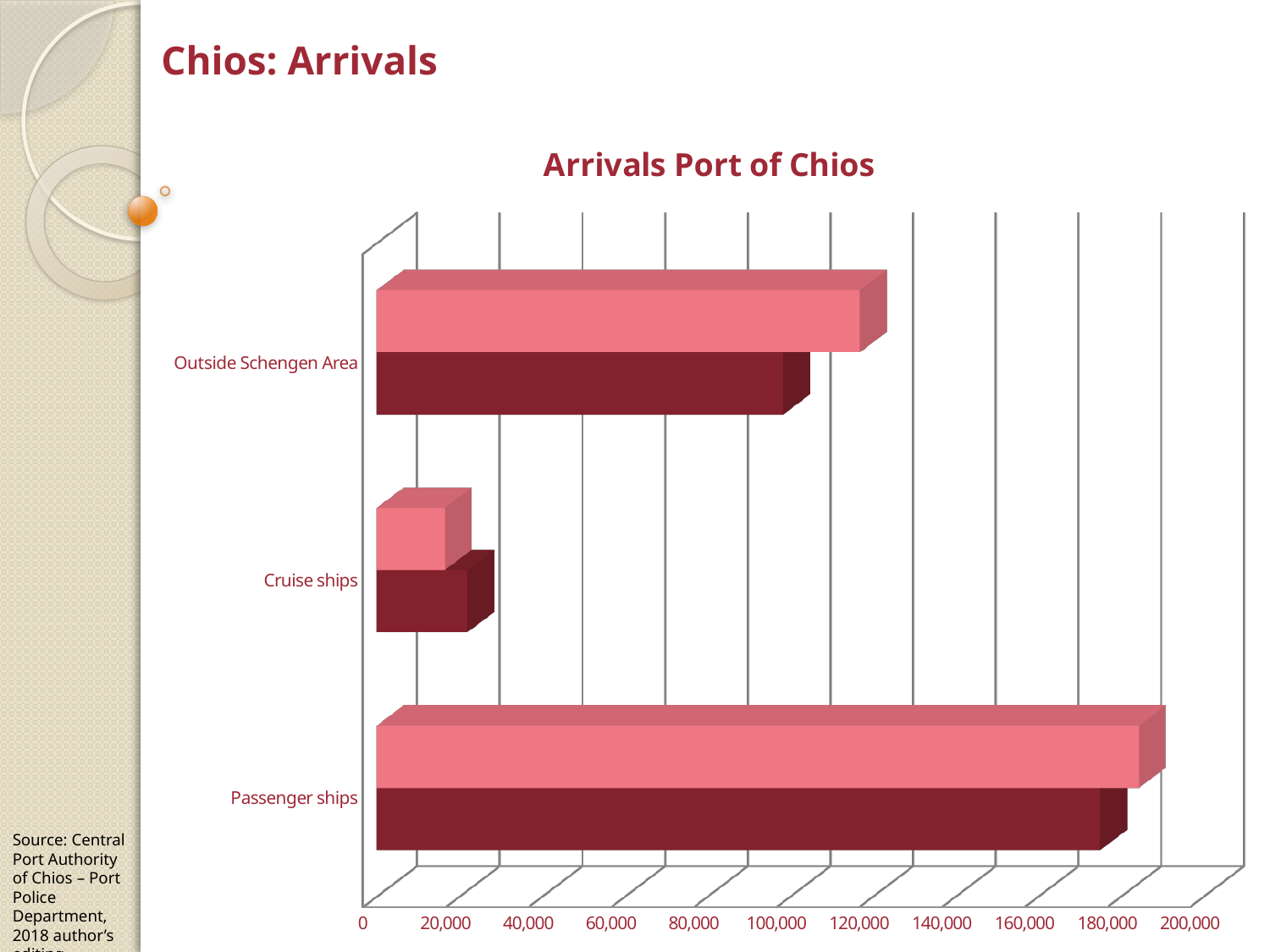
How many bars are plotted for each category on the chart? 2 What is the title of the chart on the slide? Arrivals Port of Chios What kind of chart is shown on the slide? bar chart Which category has the longest bars on the chart? Passenger ships Which category has a larger value: Passenger ships or Cruise ships? Passenger ships Which category has the shortest bars on the chart? Cruise ships Which category has a larger value: Outside Schengen Area or Cruise ships? Outside Schengen Area Is the value of the dark red bar for Cruise ships greater or less than 40,000? less How many categories are shown on the chart? 3 Is the value of the light pink bar for Passenger ships greater or less than 160,000? greater Is the value of the light pink bar for Outside Schengen Area greater or less than 80,000? greater What is the highest value shown on the horizontal axis of the chart? 200,000